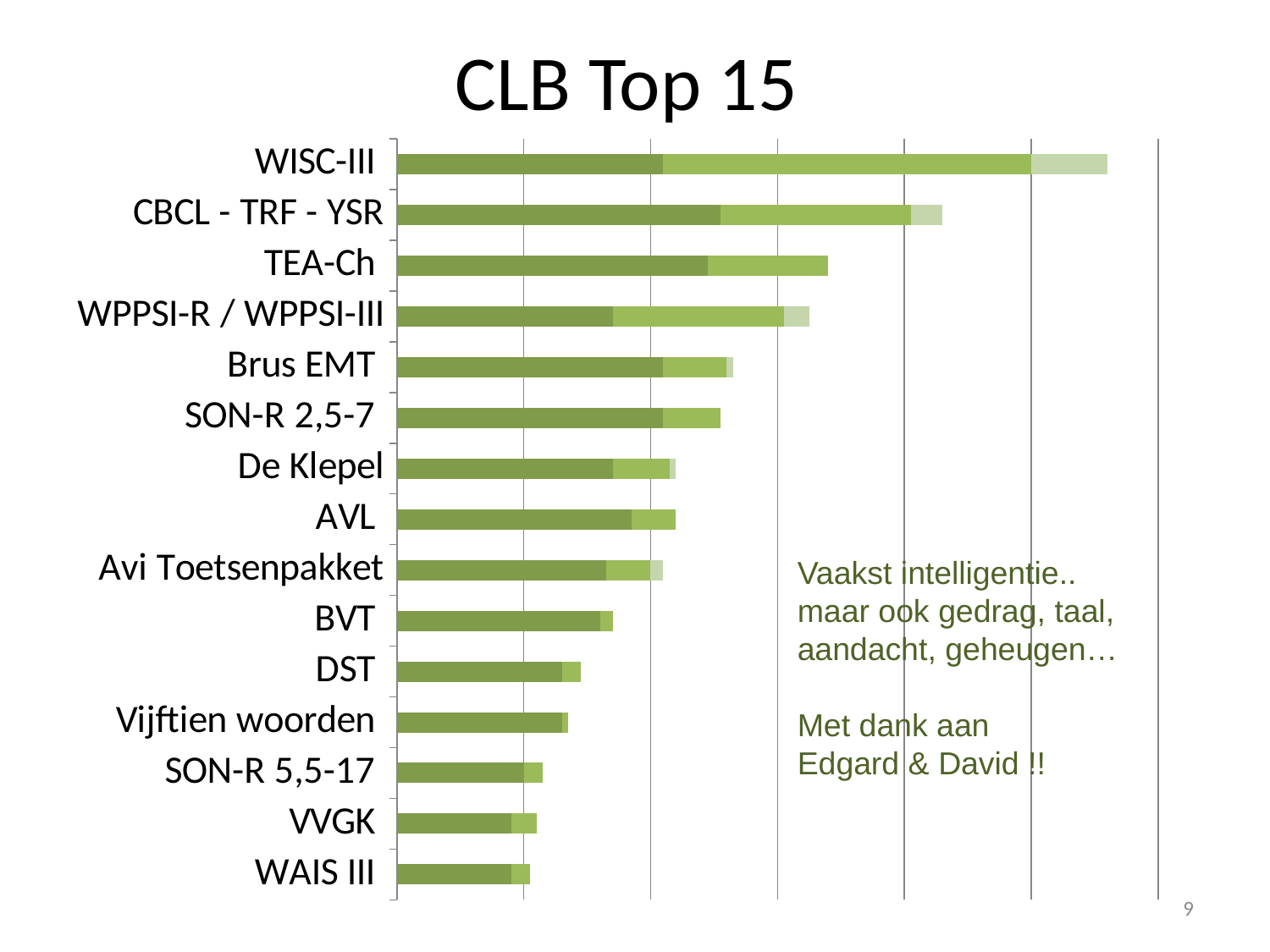
Which category has the longest bar in the chart? WISC-III Which has the larger total bar, AVL or Vijftien woorden? AVL Which has the larger total bar, TEA-Ch or SON-R 2,5-7? TEA-Ch Which has the larger total bar, CBCL - TRF - YSR or WPPSI-R / WPPSI-III? CBCL - TRF - YSR Which category is listed at the bottom of the chart? WAIS III How many categories are plotted in the chart? 15 Do the bar lengths increase or decrease going from the top category to the bottom category? decrease What is the title of the chart? CLB Top 15 What kind of chart is shown on the slide? bar chart